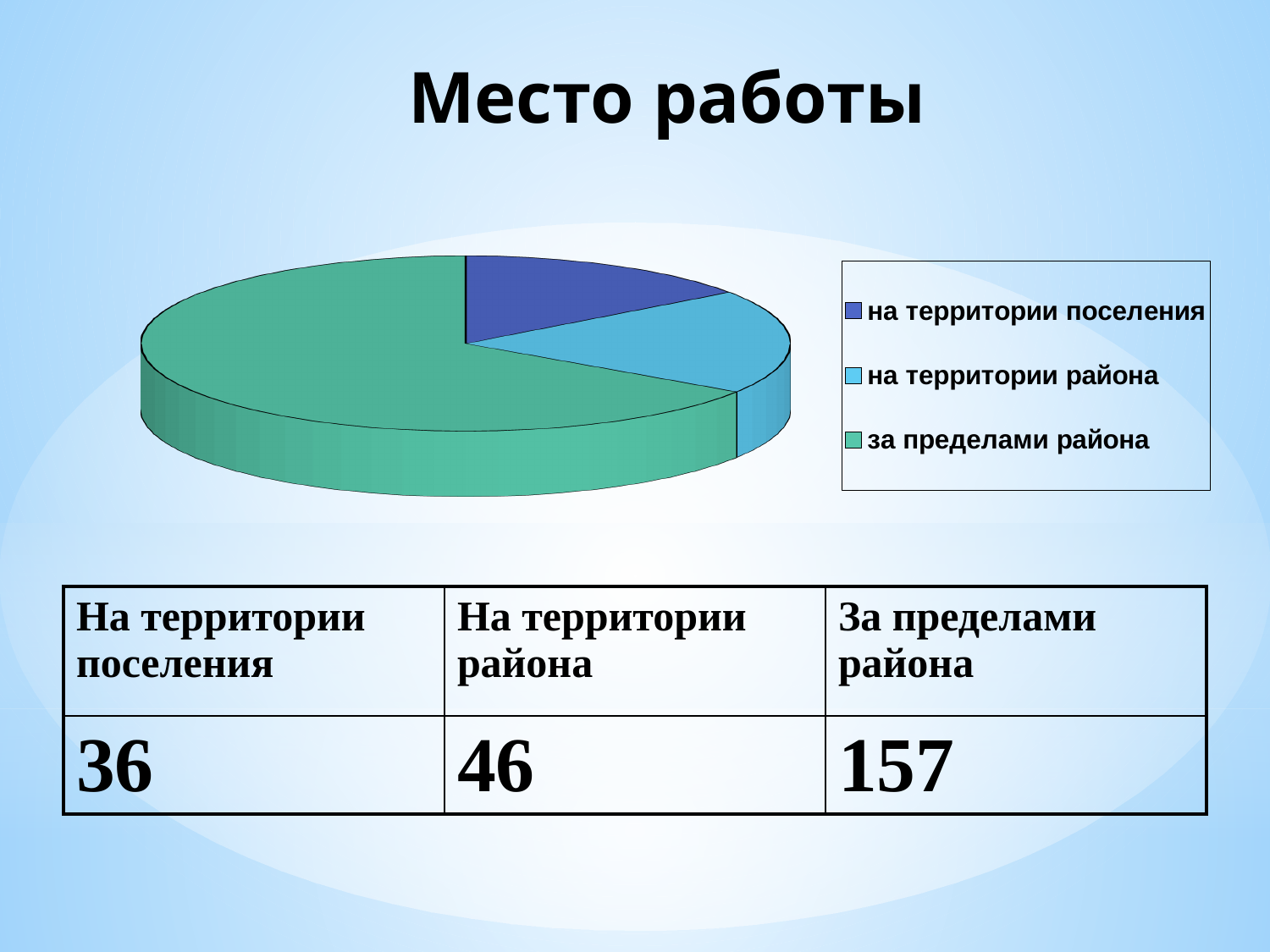
How many entries does the legend of the pie chart list? 3 Which category has the smallest slice of the pie chart? На территории поселения What is the title of the slide with the pie chart? Место работы What is the value for "За пределами района"? 157 Which category has the largest slice of the pie chart? За пределами района What is the value for "На территории района"? 46 What kind of chart is shown on the slide? pie chart Which is larger, the value for "На территории района" or the value for "На территории поселения"? На территории района What is the difference between the values for "За пределами района" and "На территории района"? 111 What is the total of the three values shown for the pie chart? 239 How many slices does the pie chart have? 3 What is the value for "На территории поселения"? 36